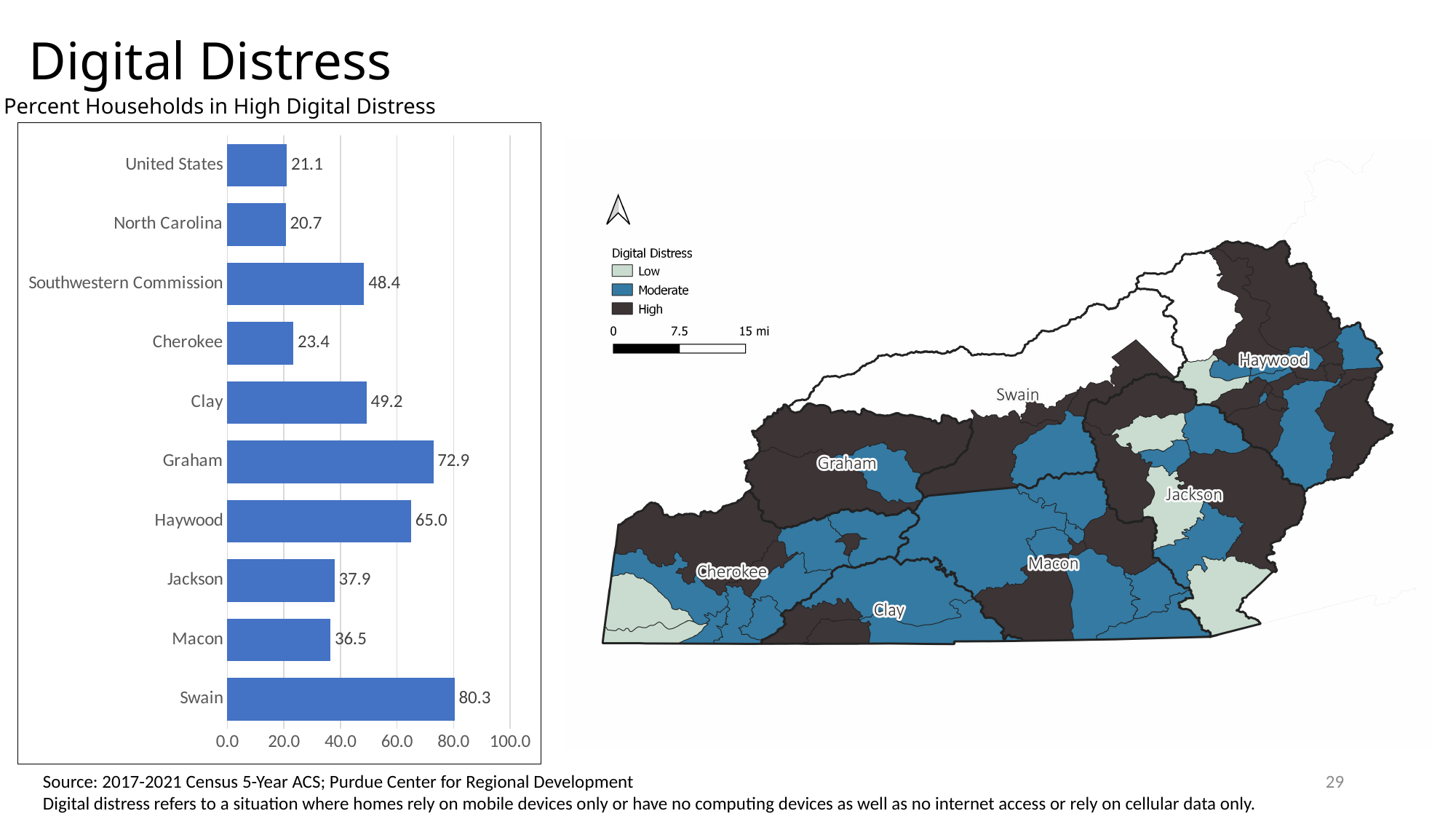
Which has a larger value in the bar chart, Jackson or Macon? Jackson Is the value for Clay in the bar chart greater or less than 40.0? greater What is the value for North Carolina in the bar chart? 20.7 What is the difference between the values for Graham and Haywood in the bar chart? 7.9 What is the difference between the values for Cherokee and United States in the bar chart? 2.3 What is the title of the bar chart? Percent Households in High Digital Distress Which category has the lowest value in the bar chart? North Carolina What kind of chart is shown on the left of the slide? bar chart How many categories are shown in the bar chart? 10 Which category has the highest value in the bar chart? Swain What is the value for Southwestern Commission in the bar chart? 48.4 What is the value for Swain in the bar chart? 80.3